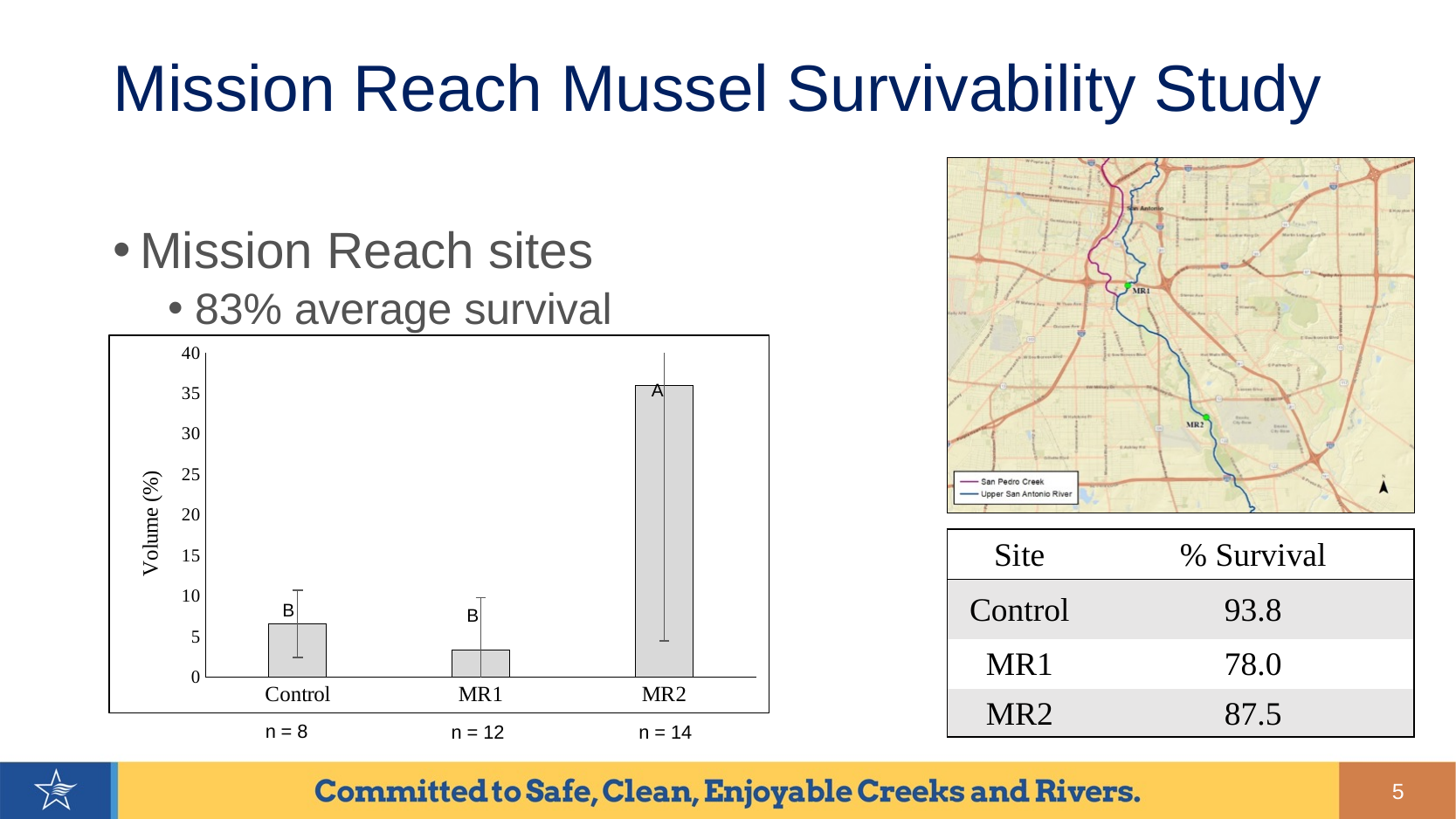
What is the highest value shown on the y axis of the chart? 40 Which category has the highest bar in the chart? MR2 What letter is printed above the MR2 bar in the chart? A Is the value for MR2 greater or less than 30? greater What is the label on the y axis of the chart? Volume (%) Is the bar for Control taller or shorter than the bar for MR1? taller How many categories are shown on the x axis of the bar chart? 3 Is the value for MR1 greater or less than 5? less Is the value for Control greater or less than 10? less What kind of chart is shown on the slide? bar chart Which category has the lowest bar in the chart? MR1